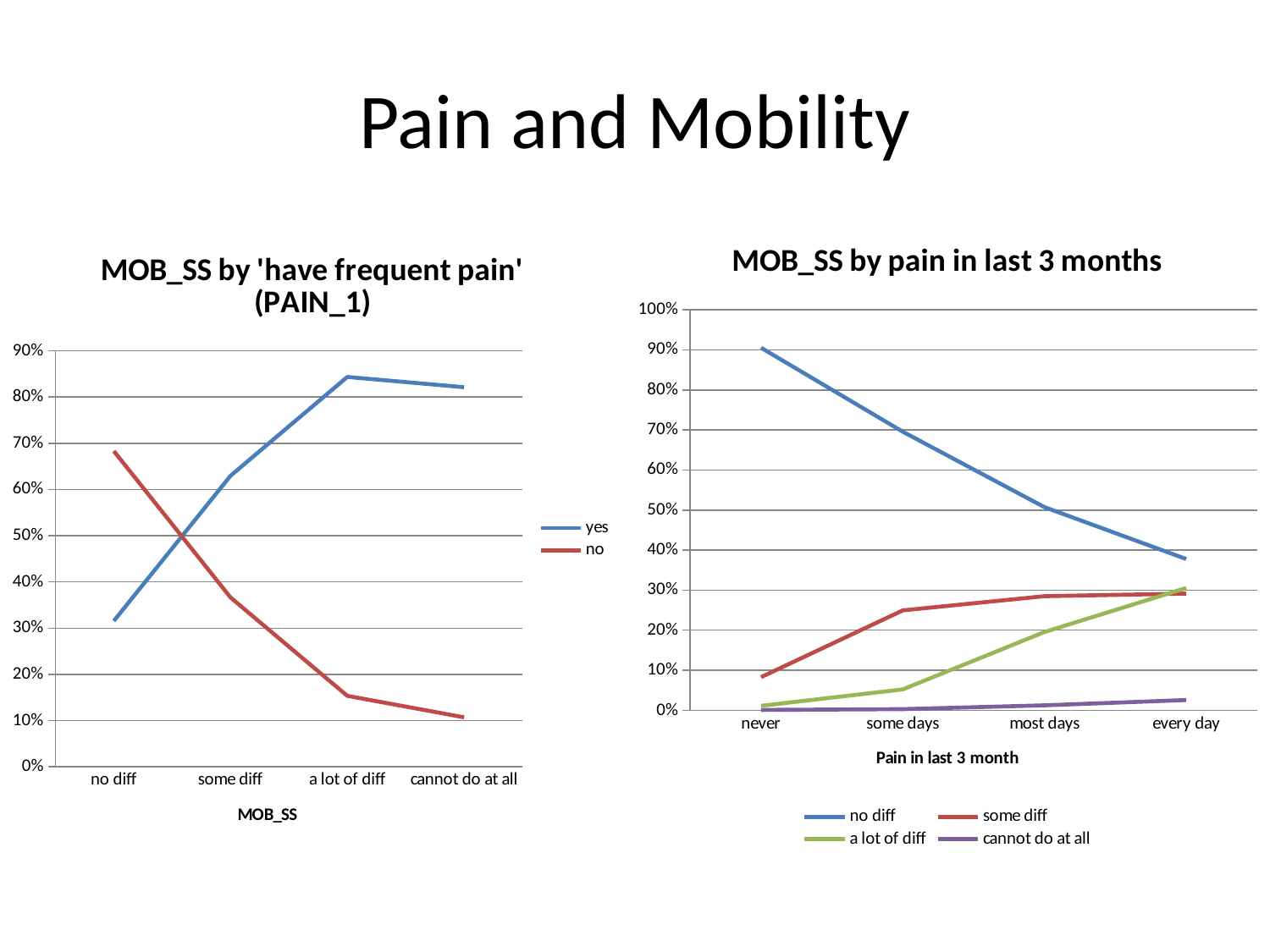
In 'MOB_SS by "have frequent pain" (PAIN_1)', is the 'no' value for 'cannot do at all' greater or less than 20%? less In 'MOB_SS by "have frequent pain" (PAIN_1)', which category has the highest 'yes' value? a lot of diff In 'MOB_SS by pain in last 3 months', which is larger at 'most days': 'no diff' or 'some diff'? no diff How many series does the legend of 'MOB_SS by pain in last 3 months' list? 4 In 'MOB_SS by pain in last 3 months', is the 'no diff' value for 'never' greater or less than 80%? greater In 'MOB_SS by pain in last 3 months', which series has the lowest value at 'every day'? cannot do at all In 'MOB_SS by pain in last 3 months', does the 'no diff' series rise or fall from 'never' to 'every day'? fall What kind of chart is 'MOB_SS by pain in last 3 months'? line chart In 'MOB_SS by "have frequent pain" (PAIN_1)', is the 'yes' value for 'no diff' greater or less than 40%? less How many categories are on the x axis of 'MOB_SS by "have frequent pain" (PAIN_1)'? 4 How many series does the legend of 'MOB_SS by "have frequent pain" (PAIN_1)' list? 2 In 'MOB_SS by "have frequent pain" (PAIN_1)', does the 'no' series rise or fall from 'no diff' to 'cannot do at all'? fall